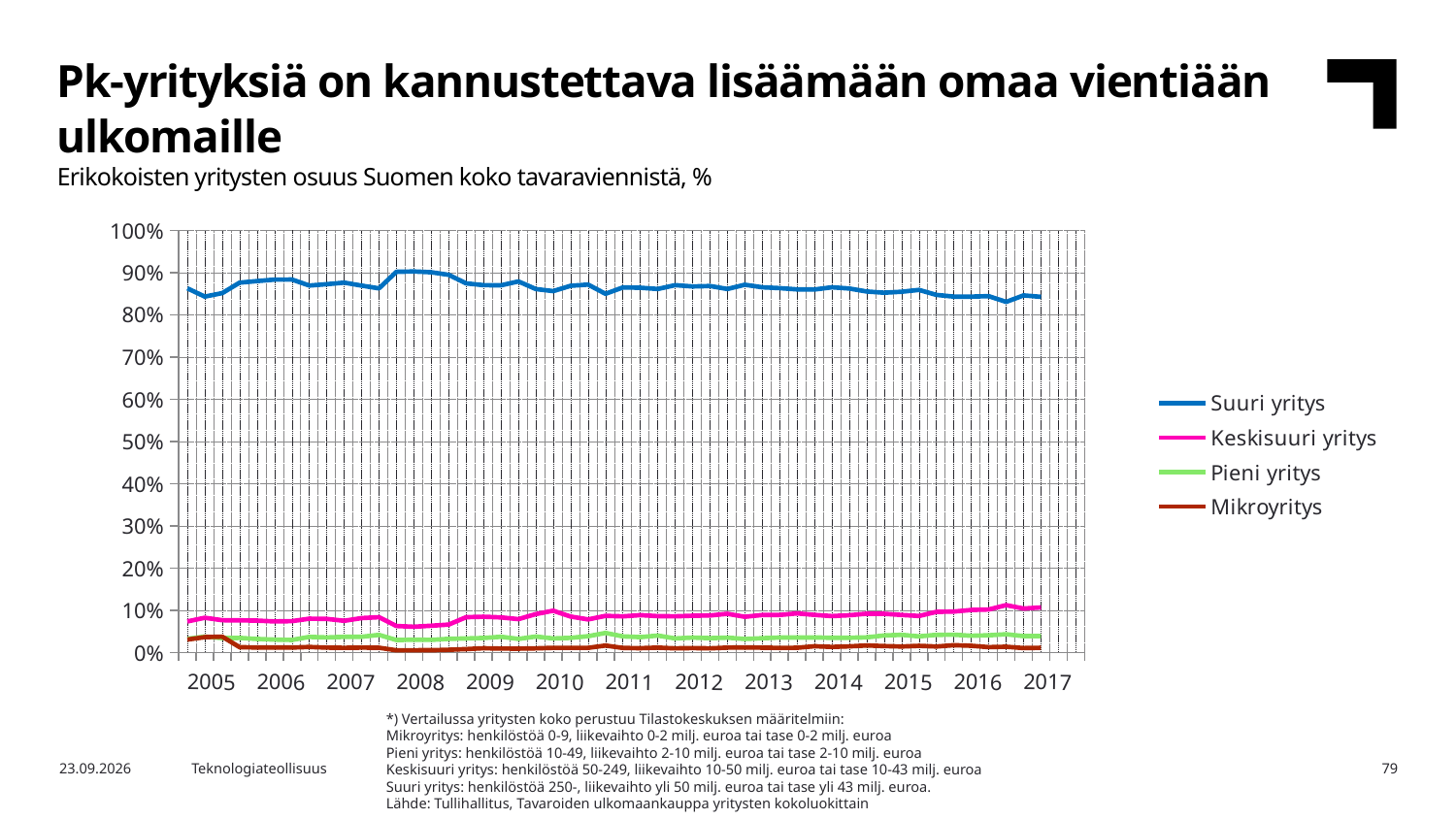
Is the value for Suuri yritys in 2008 greater or less than 80%? greater Is the value for Pieni yritys in 2015 greater or less than 10%? less Is the value for Keskisuuri yritys in 2017 greater or less than 20%? less How many series does the chart legend list? 4 Which is larger in 2012, the value for Keskisuuri yritys or the value for Pieni yritys? Keskisuuri yritys What is the subtitle describing the chart's data? Erikokoisten yritysten osuus Suomen koko tavaraviennistä, % Which colour is used for the Keskisuuri yritys series in the legend? Pink (magenta) Which series has the lowest values throughout the chart? Mikroyritys What kind of chart is shown on the slide? Line chart How many years are labelled on the x axis of the chart? 13 Which series has the highest values throughout the chart? Suuri yritys